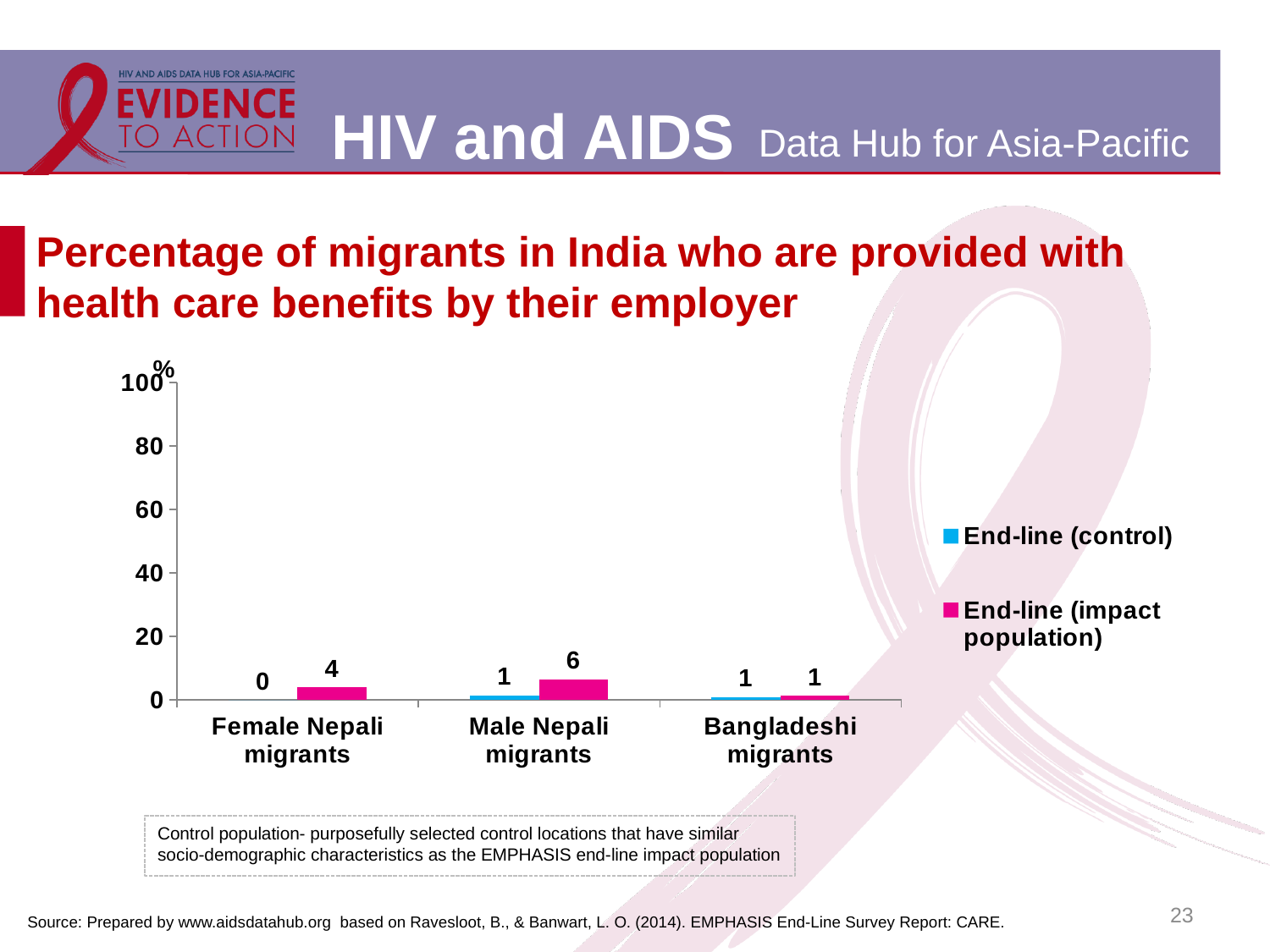
Which category has the highest End-line (impact population) value? Male Nepali migrants What kind of chart is shown on the slide? Bar chart What is the difference between the End-line (impact population) and End-line (control) values for Male Nepali migrants? 5 Which category has the lowest End-line (control) value? Female Nepali migrants What is the End-line (control) value for Female Nepali migrants? 0 Which is larger for Female Nepali migrants: the End-line (control) value or the End-line (impact population) value? End-line (impact population) What is the End-line (control) value for Male Nepali migrants? 1 What colour represents the End-line (impact population) series? Pink What is the End-line (impact population) value for Bangladeshi migrants? 1 How many migrant categories are shown on the x axis? 3 What is the End-line (impact population) value for Male Nepali migrants? 6 How many series does the legend list? 2